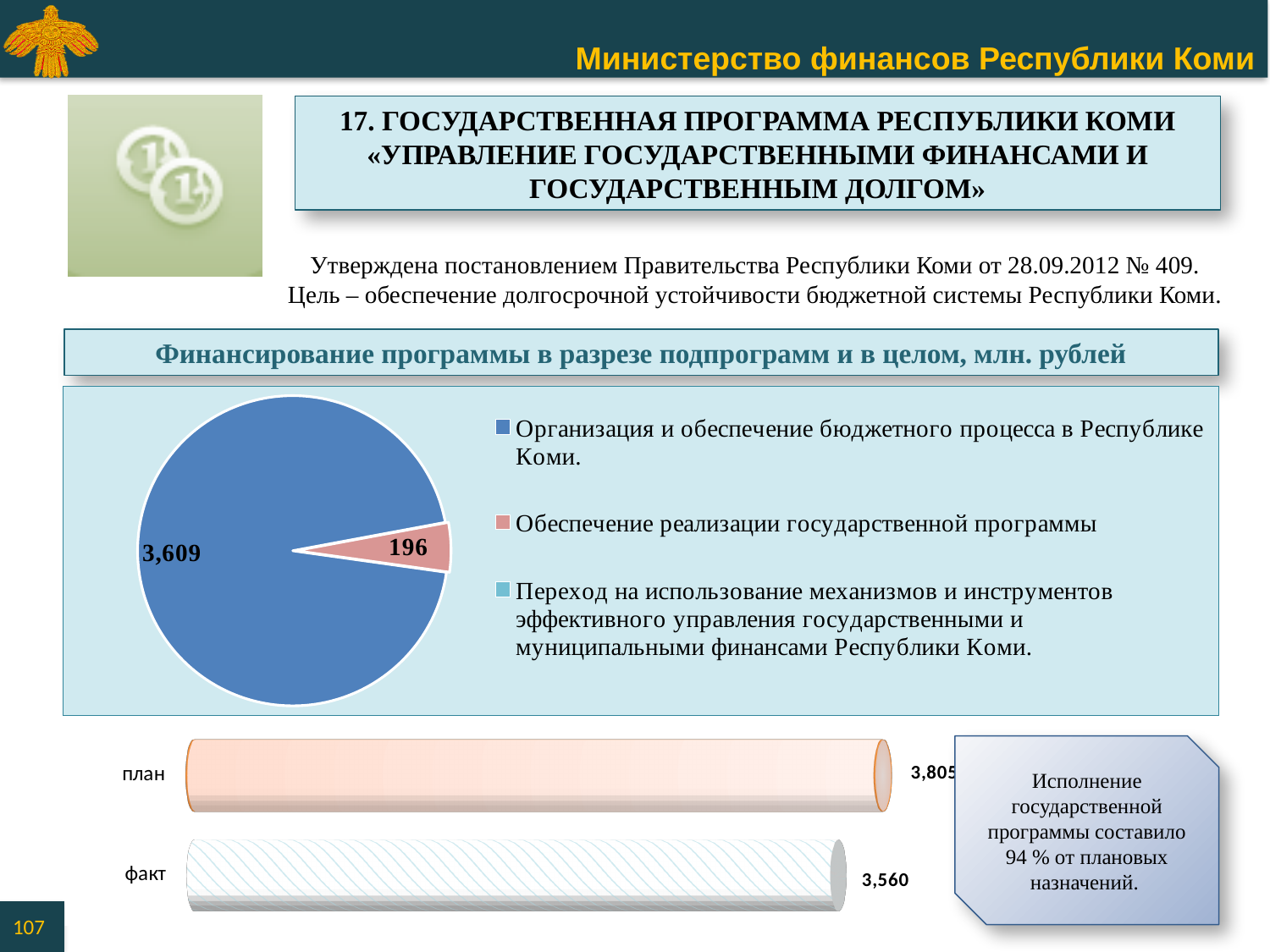
What kind of chart is the upper chart on the slide? Pie chart In the pie chart, which subprogram has the largest slice? Организация и обеспечение бюджетного процесса в Республике Коми In the pie chart, what is the difference between the values 3,609 and 196? 3,413 How many entries does the legend of the pie chart list? 3 In the bar chart at the bottom, what is the difference between «план» and «факт»? 245 How many bars are shown in the bar chart at the bottom of the slide? 2 In the pie chart, what is the value for «Обеспечение реализации государственной программы»? 196 In the pie chart, what is the value for «Организация и обеспечение бюджетного процесса в Республике Коми»? 3,609 In the bar chart at the bottom, what is the value for «факт»? 3,560 In the bar chart at the bottom, what is the value for «план»? 3,805 In the pie chart, what colour is the slice for «Обеспечение реализации государственной программы»? Pink (red) In the bar chart at the bottom, which is larger, «план» or «факт»? план